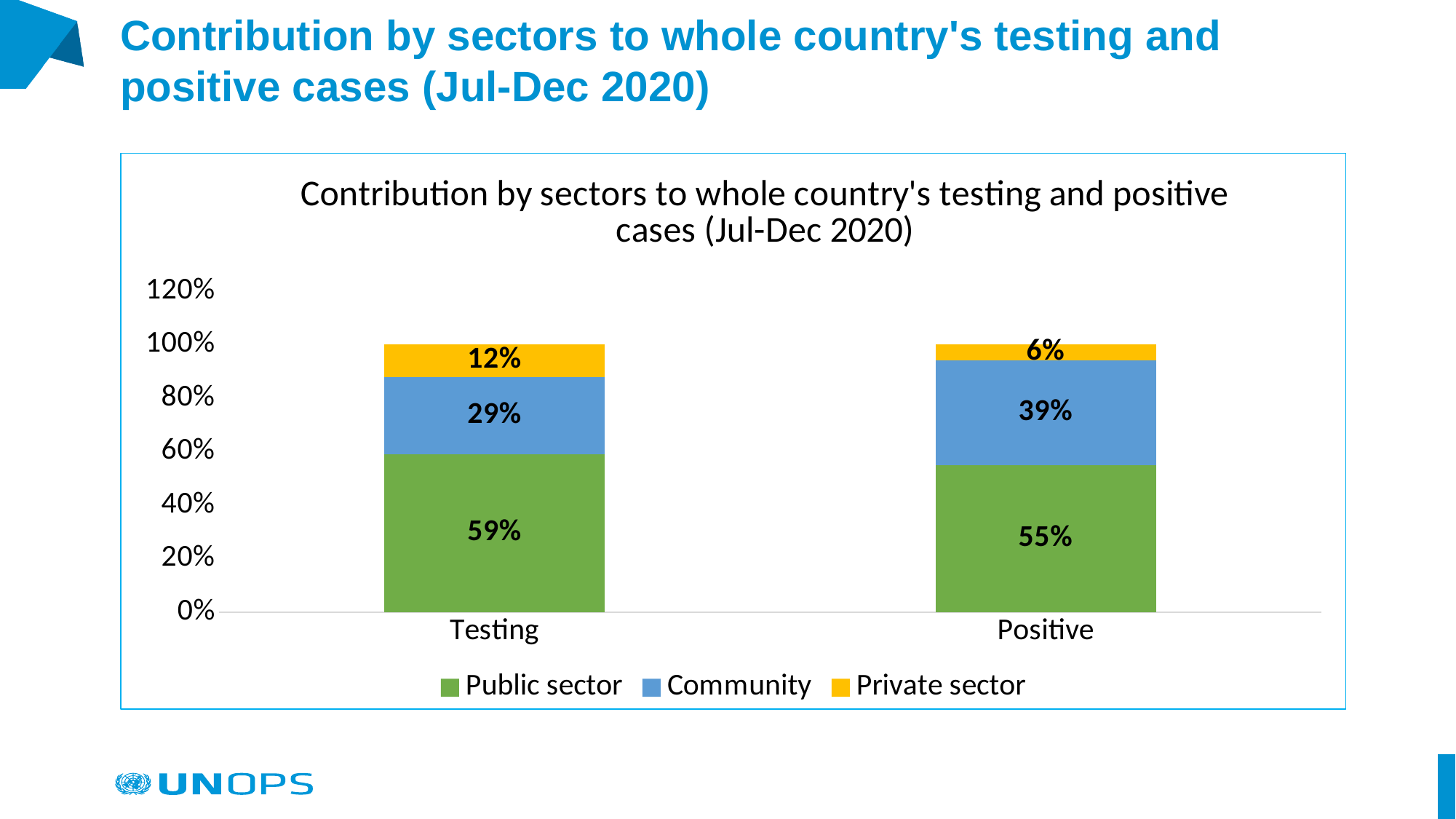
What is the Private sector value for Positive? 6% What is the Private sector value for Testing? 12% Is the Public sector value larger for Testing or for Positive? Testing Which sector has the largest share of Positive cases? Public sector What is the Community value for Positive? 39% What kind of chart is shown? Stacked bar chart How many series does the legend list? 3 How many categories are shown on the x axis? 2 What is the Public sector value for Testing? 59% What is the difference between the Community value for Positive and the Community value for Testing? 10% Which sector has the smallest share of Testing? Private sector Which colour represents the Private sector in the chart? Yellow